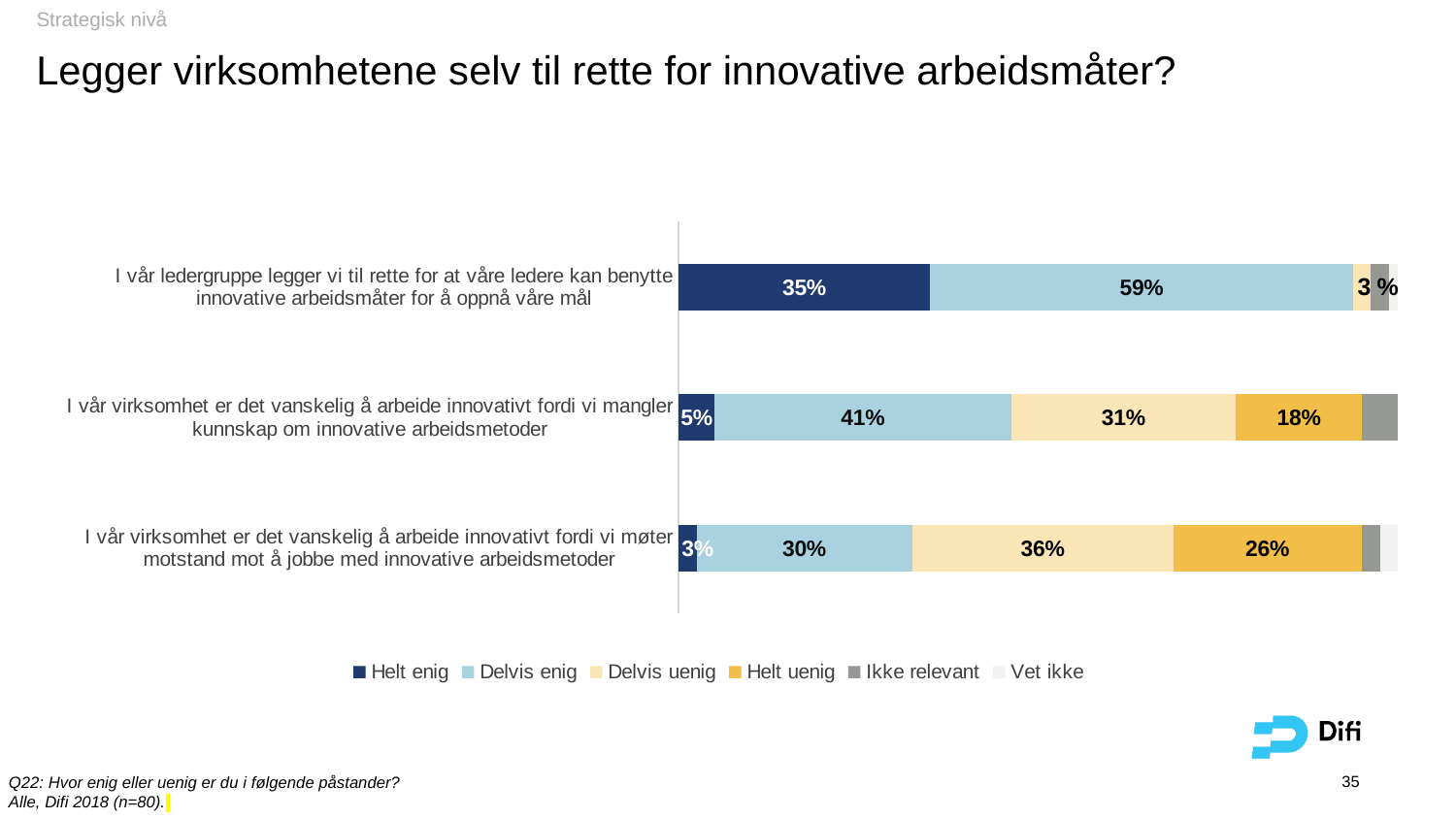
What share answered 'Delvis enig' to the statement 'I vår ledergruppe legger vi til rette for at våre ledere kan benytte innovative arbeidsmåter for å oppnå våre mål'? 59% Which colour represents 'Helt uenig' in the legend? Orange/yellow Which statement has the lowest 'Helt enig' share? I vår virksomhet er det vanskelig å arbeide innovativt fordi vi møter motstand mot å jobbe med innovative arbeidsmetoder What kind of chart is shown on the slide? Stacked bar chart What share answered 'Helt enig' to the statement 'I vår ledergruppe legger vi til rette for at våre ledere kan benytte innovative arbeidsmåter for å oppnå våre mål'? 35% Which statement has the highest 'Delvis enig' share? I vår ledergruppe legger vi til rette for at våre ledere kan benytte innovative arbeidsmåter for å oppnå våre mål How many series does the legend list? 6 What share answered 'Helt uenig' to the statement 'I vår virksomhet er det vanskelig å arbeide innovativt fordi vi møter motstand mot å jobbe med innovative arbeidsmetoder'? 26% What share answered 'Delvis uenig' to the statement 'I vår virksomhet er det vanskelig å arbeide innovativt fordi vi mangler kunnskap om innovative arbeidsmetoder'? 31% For the 'mangler kunnskap' statement, which is larger: the 'Delvis enig' share or the 'Delvis uenig' share? Delvis enig What is the difference between the 'Helt uenig' shares for the 'møter motstand' statement and the 'mangler kunnskap' statement? 8 percentage points How many statements (categories) are plotted in the chart? 3